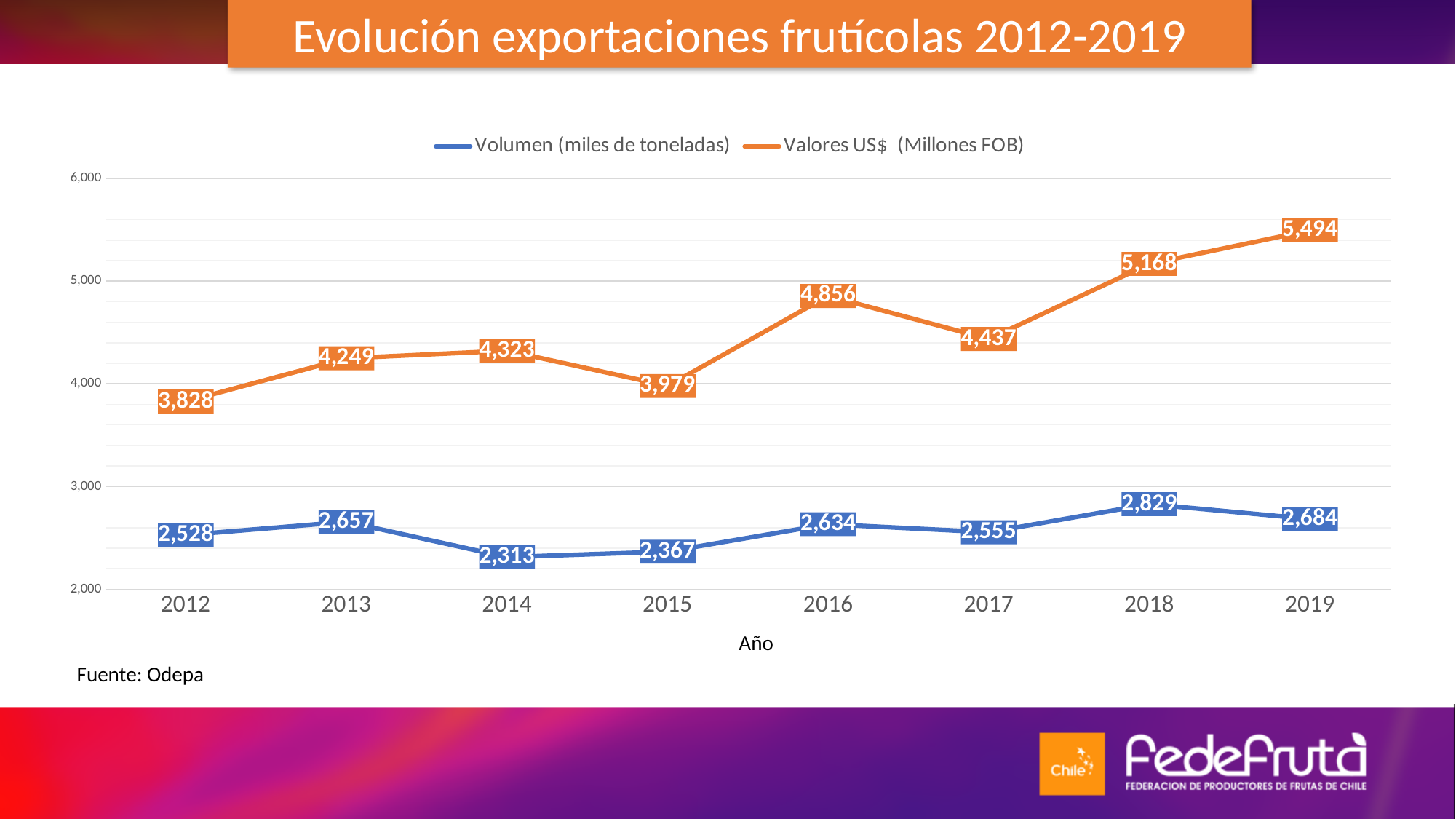
What is the difference between Valores US$ (Millones FOB) in 2019 and in 2012? 1,666 In which year is Valores US$ (Millones FOB) lowest? 2012 What is the value of Valores US$ (Millones FOB) in 2015? 3,979 What is the Volumen (miles de toneladas) in 2014? 2,313 In which year is Volumen (miles de toneladas) highest? 2018 How many years are shown on the x axis? 8 What is the title of the chart? Evolución exportaciones frutícolas 2012-2019 What is the value of Valores US$ (Millones FOB) in 2019? 5,494 Which is larger: Valores US$ (Millones FOB) in 2016 or in 2017? 2016 What is the difference between Volumen (miles de toneladas) in 2018 and in 2017? 274 How many series does the legend list? 2 What kind of chart is shown on the slide? Line chart